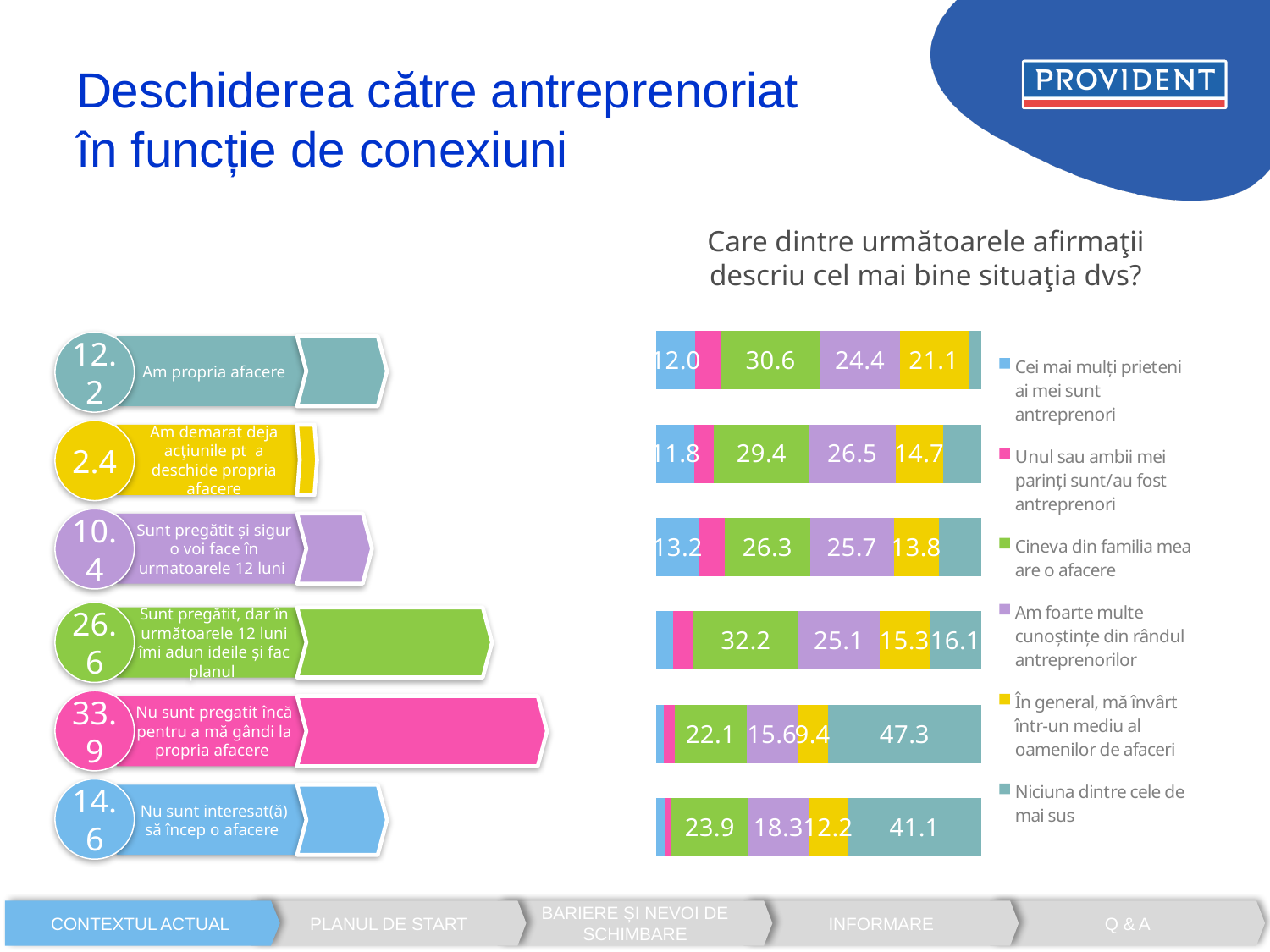
In the third bar from the top, what is the value of the blue segment (Cei mai mulți prieteni ai mei sunt antreprenori)? 13.2 In the fifth bar from the top, which series has the largest segment? Niciuna dintre cele de mai sus In the bottom bar of the chart, what is the value of the teal segment (Niciuna dintre cele de mai sus)? 41.1 How many stacked bars are plotted in the chart? 6 In the fifth bar from the top, what is the value for 'Niciuna dintre cele de mai sus'? 47.3 In the fourth bar from the top, what is the value of the green segment (Cineva din familia mea are o afacere)? 32.2 How many series does the legend of the stacked bar chart list? 6 In the top bar, which is larger: the segment for 'Cineva din familia mea are o afacere' or the segment for 'Am foarte multe cunoștințe din rândul antreprenorilor'? Cineva din familia mea are o afacere Which colour represents 'Unul sau ambii mei parinți sunt/au fost antreprenori' in the chart legend? Pink In the bottom bar, what is the difference between the teal segment (41.1) and the green segment (23.9)? 17.2 In the top bar of the chart, what is the value of the green segment (Cineva din familia mea are o afacere)? 30.6 What kind of chart is shown on the right of the slide? Stacked bar chart